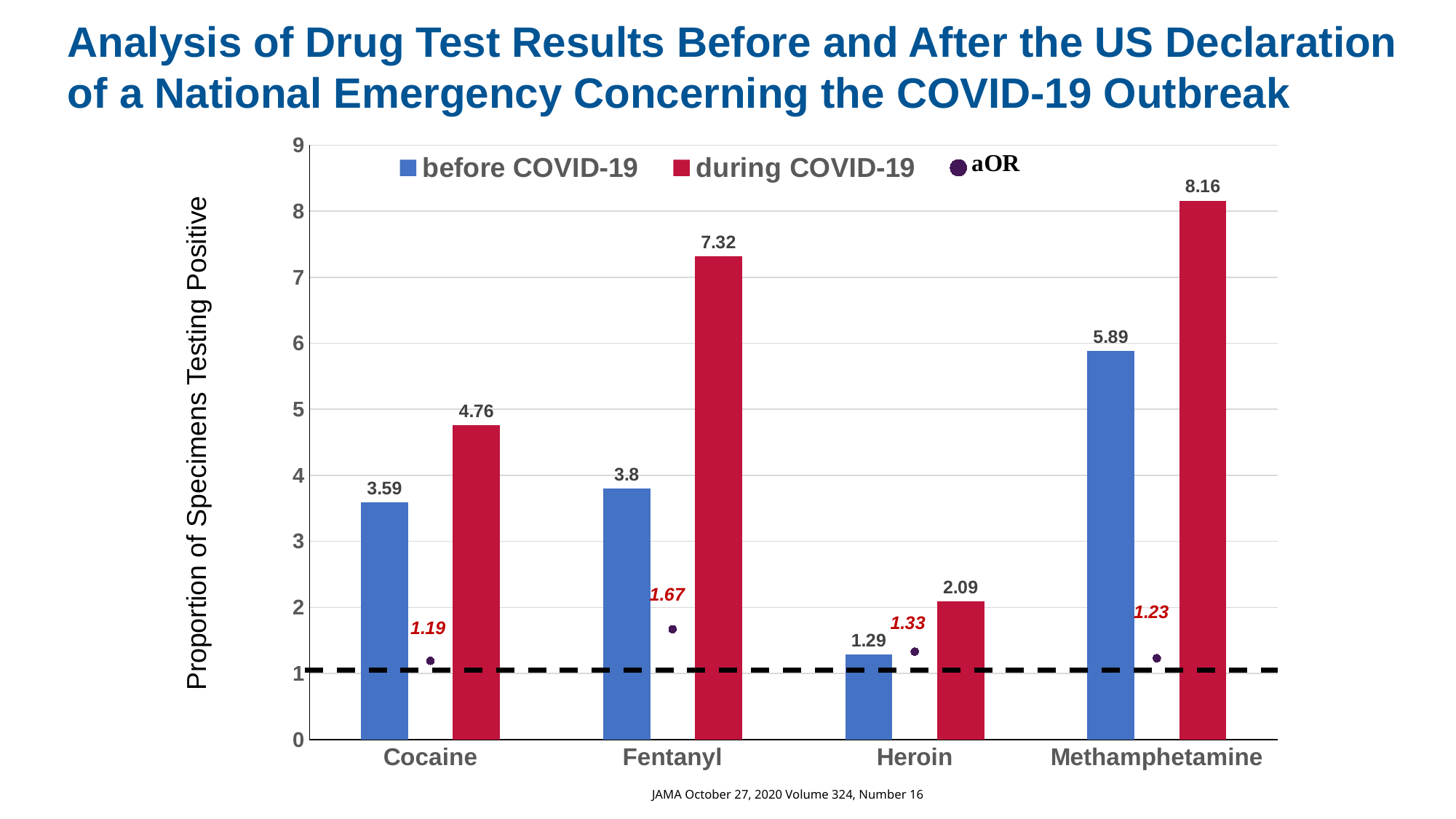
Which drug has the lowest 'before COVID-19' value? Heroin Which is larger for Heroin: the 'before COVID-19' value or the 'during COVID-19' value? during COVID-19 What is the aOR value shown for Heroin? 1.33 Is the 'during COVID-19' value for Methamphetamine greater or less than 8? greater What kind of chart is used to show the proportion of specimens testing positive? bar chart How many drug categories are shown on the x axis? 4 Which drug has the highest 'during COVID-19' value? Methamphetamine Which drug has the highest aOR value? Fentanyl What is the 'before COVID-19' value for Methamphetamine? 5.89 What is the 'during COVID-19' value for Fentanyl? 7.32 What is the difference between the 'during COVID-19' and 'before COVID-19' values for Cocaine? 1.17 How many series does the legend list? 3